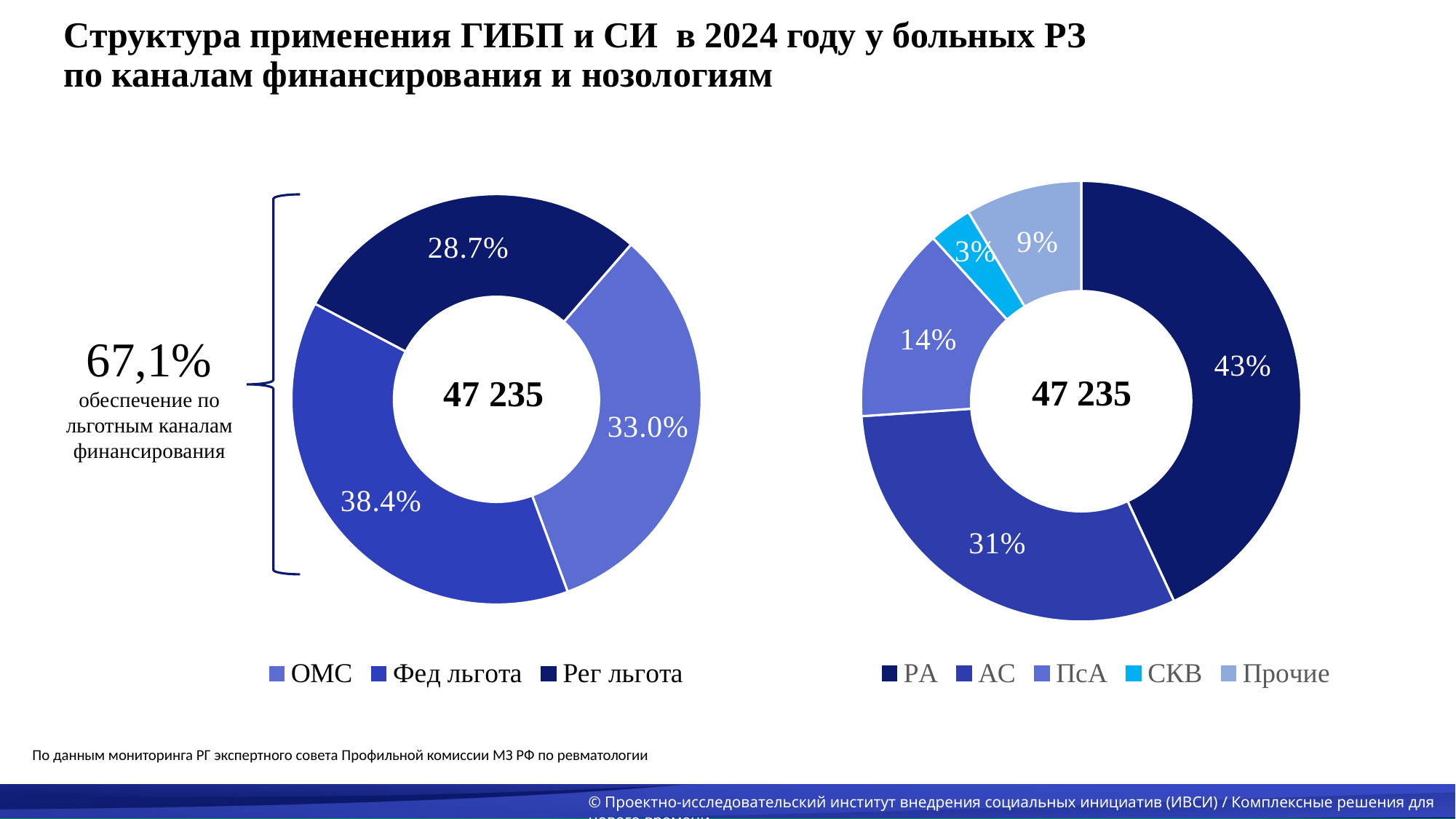
In the right chart (nosologies), what is the share for СКВ? 3% In the left chart (funding channels), what is the share for Фед льгота? 38.4% In the left chart (funding channels), what is the share for Рег льгота? 28.7% In the left chart (funding channels), which category has the largest share? Фед льгота What type of chart is the left chart (funding channels)? Doughnut chart In the right chart (nosologies), which category has the largest share? РА In the left chart (funding channels), which category has the smallest share? Рег льгота In the right chart (nosologies), what is the share for ПсА? 14% In the left chart (funding channels), what is the difference between the shares of ОМС and Рег льгота? 4.3% In the right chart (nosologies), how many categories does the legend list? 5 In the right chart (nosologies), which is larger, the share for АС or the share for Прочие? АС What number is shown in the centre of the right chart (nosologies)? 47 235